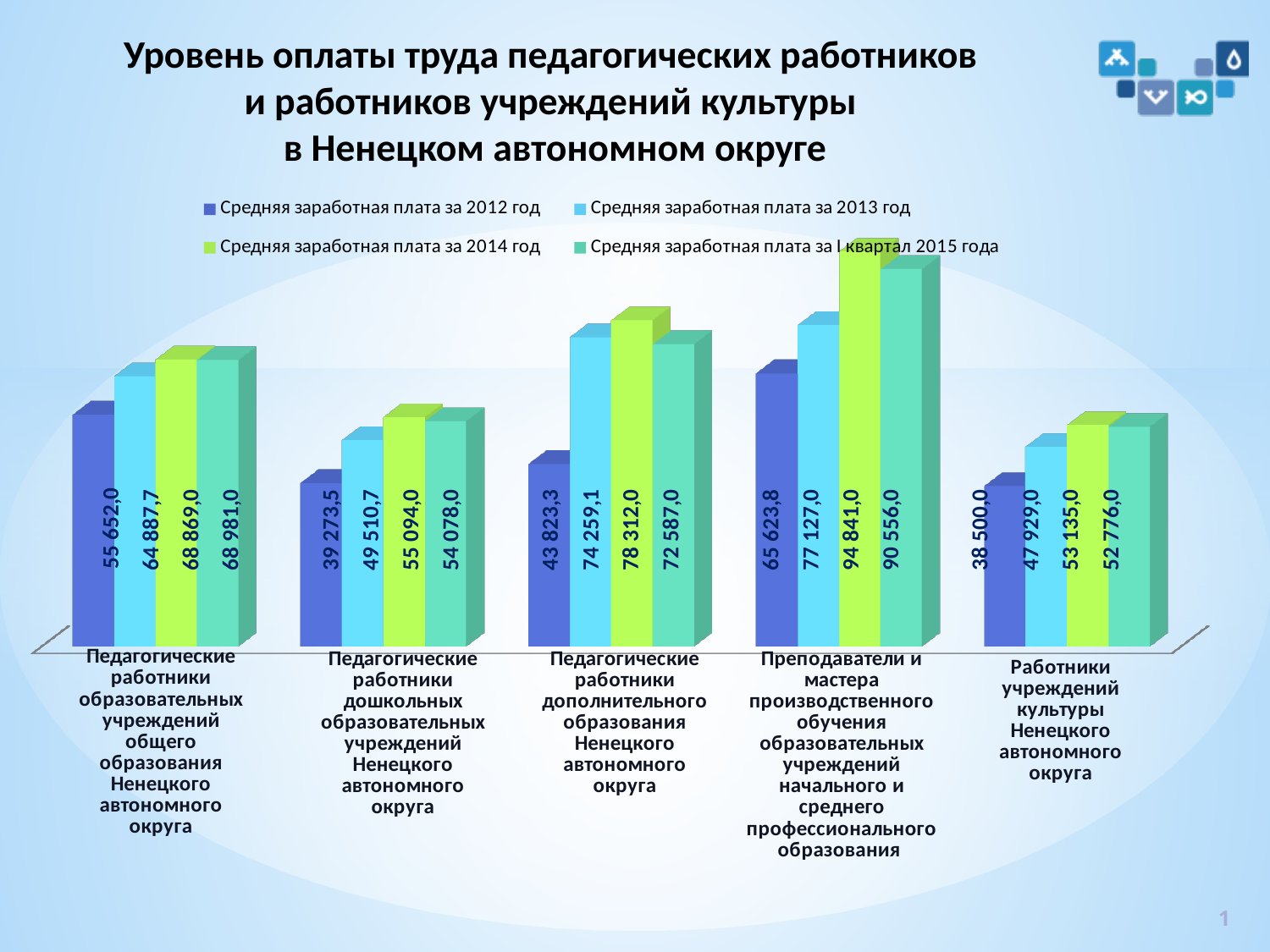
Which is larger for Педагогические работники дополнительного образования: the 2014 value or the I квартал 2015 value? 2014 value (78 312,0) What is the average salary for 2014 (Средняя заработная плата за 2014 год) for Преподаватели и мастера производственного обучения? 94 841,0 For Преподаватели и мастера производственного обучения, do the values rise or fall from 2012 to 2014? Rise What kind of chart is shown on the slide? Bar chart Which category has the highest value for Средняя заработная плата за 2013 год? Преподаватели и мастера производственного обучения образовательных учреждений начального и среднего профессионального образования What is the difference between the I квартал 2015 value and the 2012 value for Педагогические работники образовательных учреждений общего образования? 13 329,0 What is the value for I квартал 2015 года for Педагогические работники дошкольных образовательных учреждений? 54 078,0 How many categories are shown on the x axis of the chart? 5 How many series does the legend list? 4 What is the average salary for 2012 for Работники учреждений культуры Ненецкого автономного округа? 38 500,0 Which category has the lowest value for Средняя заработная плата за 2012 год? Работники учреждений культуры Ненецкого автономного округа What is the difference between the 2014 value and the I квартал 2015 value for Преподаватели и мастера производственного обучения? 4 285,0